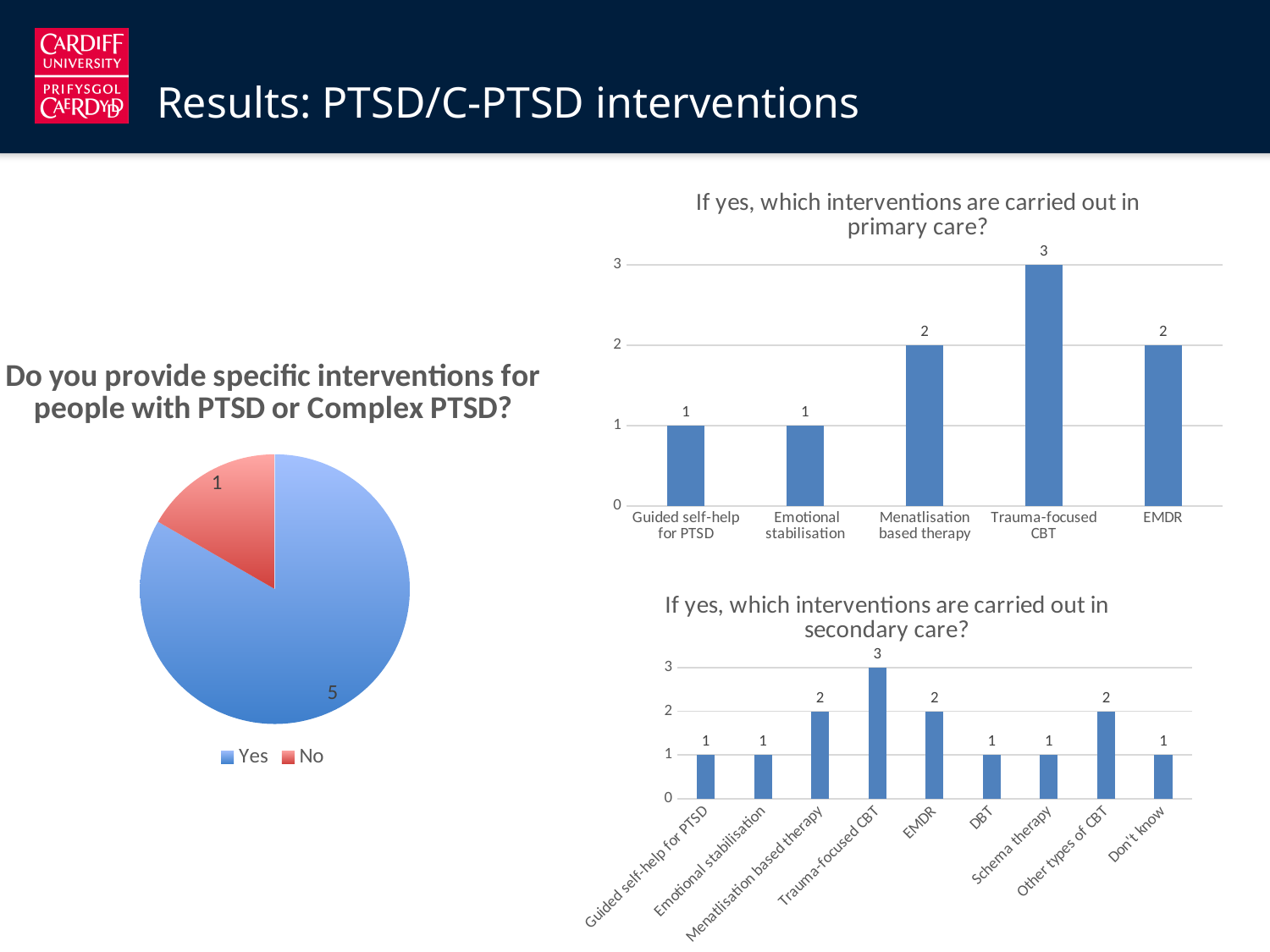
What kind of chart is 'If yes, which interventions are carried out in secondary care?'? Bar chart In the chart 'If yes, which interventions are carried out in primary care?', what is the difference between Trauma-focused CBT and Guided self-help for PTSD? 2 In the pie chart 'Do you provide specific interventions for people with PTSD or Complex PTSD?', what share of respondents answered No? 1 out of 6 In the chart 'If yes, which interventions are carried out in secondary care?', what is the value for Don't know? 1 What kind of chart is 'Do you provide specific interventions for people with PTSD or Complex PTSD?'? Pie chart In the pie chart 'Do you provide specific interventions for people with PTSD or Complex PTSD?', how many respondents answered Yes? 5 In the chart 'If yes, which interventions are carried out in secondary care?', which is larger, EMDR or DBT? EMDR In the chart 'If yes, which interventions are carried out in primary care?', what is the value for Trauma-focused CBT? 3 In the chart 'If yes, which interventions are carried out in secondary care?', how many interventions are shown on the x axis? 9 In the chart 'If yes, which interventions are carried out in primary care?', which intervention has the highest value? Trauma-focused CBT In the chart 'If yes, which interventions are carried out in primary care?', how many interventions are shown on the x axis? 5 In the chart 'If yes, which interventions are carried out in secondary care?', what is the value for Other types of CBT? 2